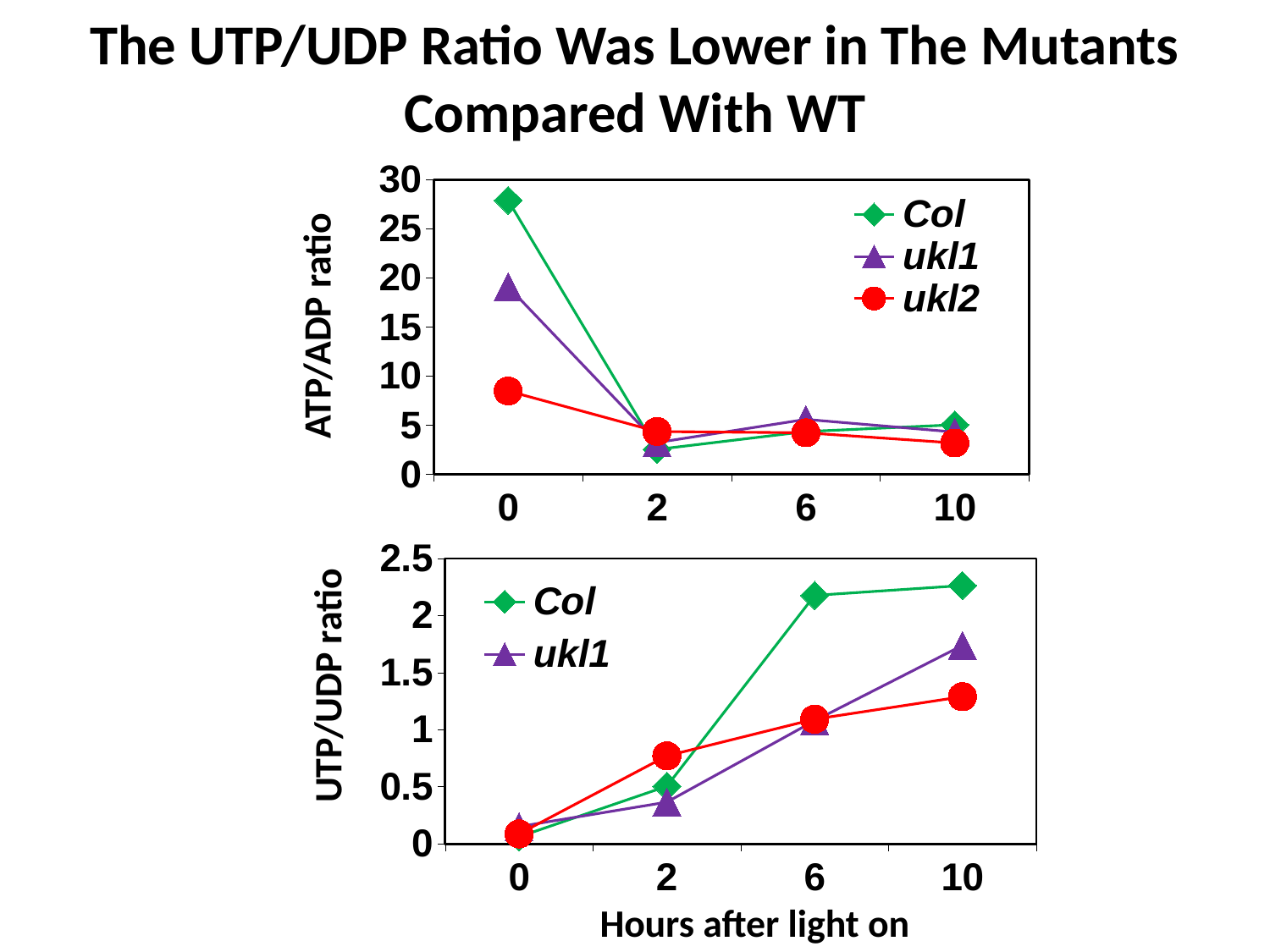
What kind of chart is the top chart (ATP/ADP ratio)? line chart In the top chart (ATP/ADP ratio), which is larger at 0 hours, ukl1 or ukl2? ukl1 In the bottom chart (UTP/UDP ratio), is the value for Col at 10 hours greater or less than 2? greater What is the x-axis label of the bottom chart? Hours after light on In the top chart (ATP/ADP ratio), is the value for ukl2 at 0 hours greater or less than 10? less In the top chart (ATP/ADP ratio), is the value for Col at 0 hours greater or less than 25? greater In the bottom chart (UTP/UDP ratio), which series has the highest value at 10 hours? Col In the top chart (ATP/ADP ratio), which series has the highest value at 0 hours? Col In the bottom chart (UTP/UDP ratio), how many series does the legend list? 2 In the bottom chart (UTP/UDP ratio), how many time points are shown on the x axis? 4 In the top chart (ATP/ADP ratio), does the Col series rise or fall from 0 to 2 hours? fall In the top chart (ATP/ADP ratio), how many series does the legend list? 3